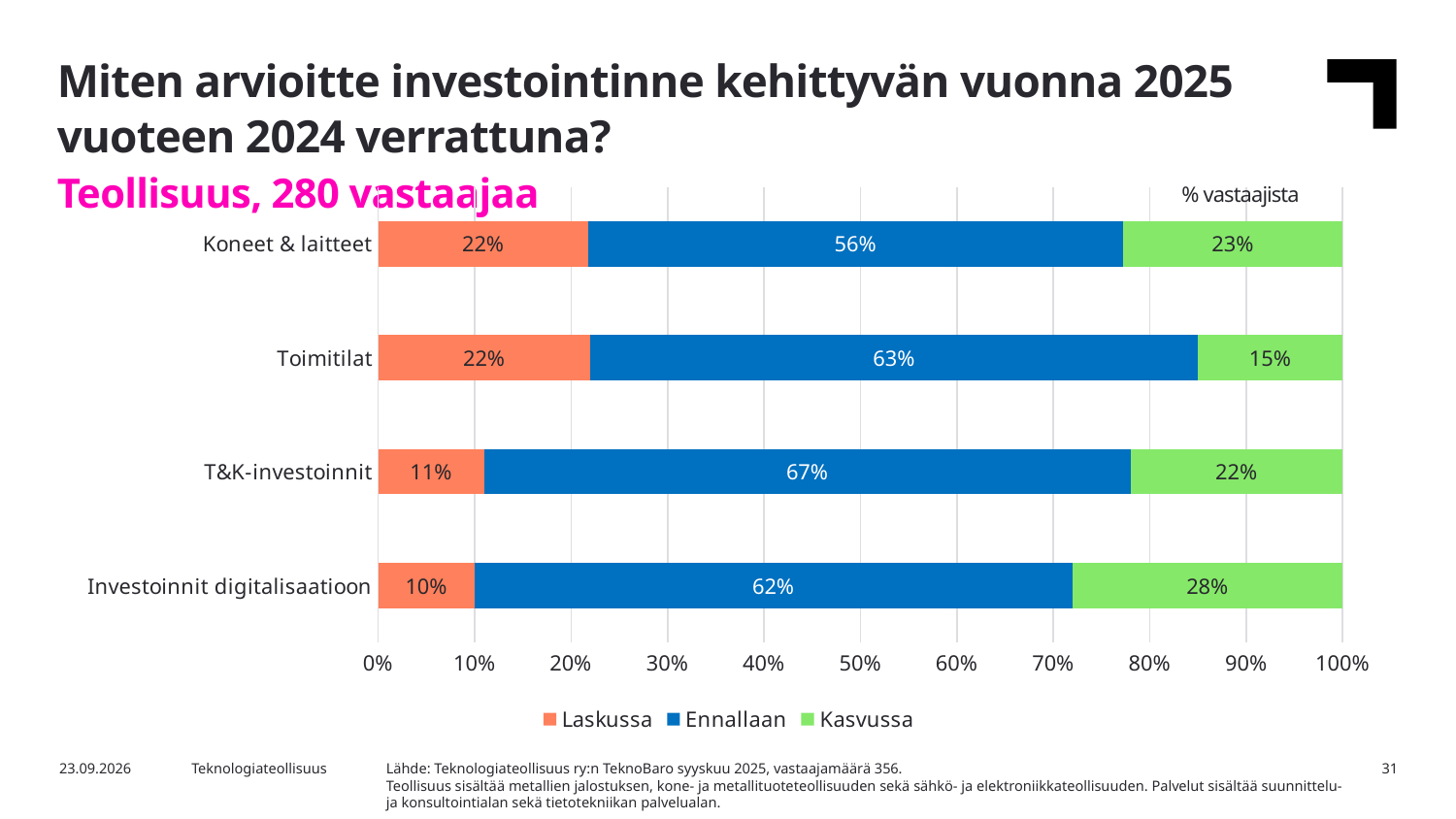
What is the difference between the Kasvussa values for Investoinnit digitalisaatioon and Toimitilat? 13 percentage points How many series does the legend list? 3 What is the total of the stacked bar for Toimitilat? 100% What is the Laskussa value for T&K-investoinnit? 11% What kind of chart is shown on the slide? Stacked bar chart Which is larger, the Laskussa value for Koneet & laitteet or the Laskussa value for T&K-investoinnit? Koneet & laitteet How many categories are shown on the chart? 4 What is the Kasvussa value for Toimitilat? 15% What is the Ennallaan value for Koneet & laitteet? 56% Which category has the lowest Laskussa value? Investoinnit digitalisaatioon Which category has the highest Ennallaan value? T&K-investoinnit What is the Kasvussa value for Investoinnit digitalisaatioon? 28%